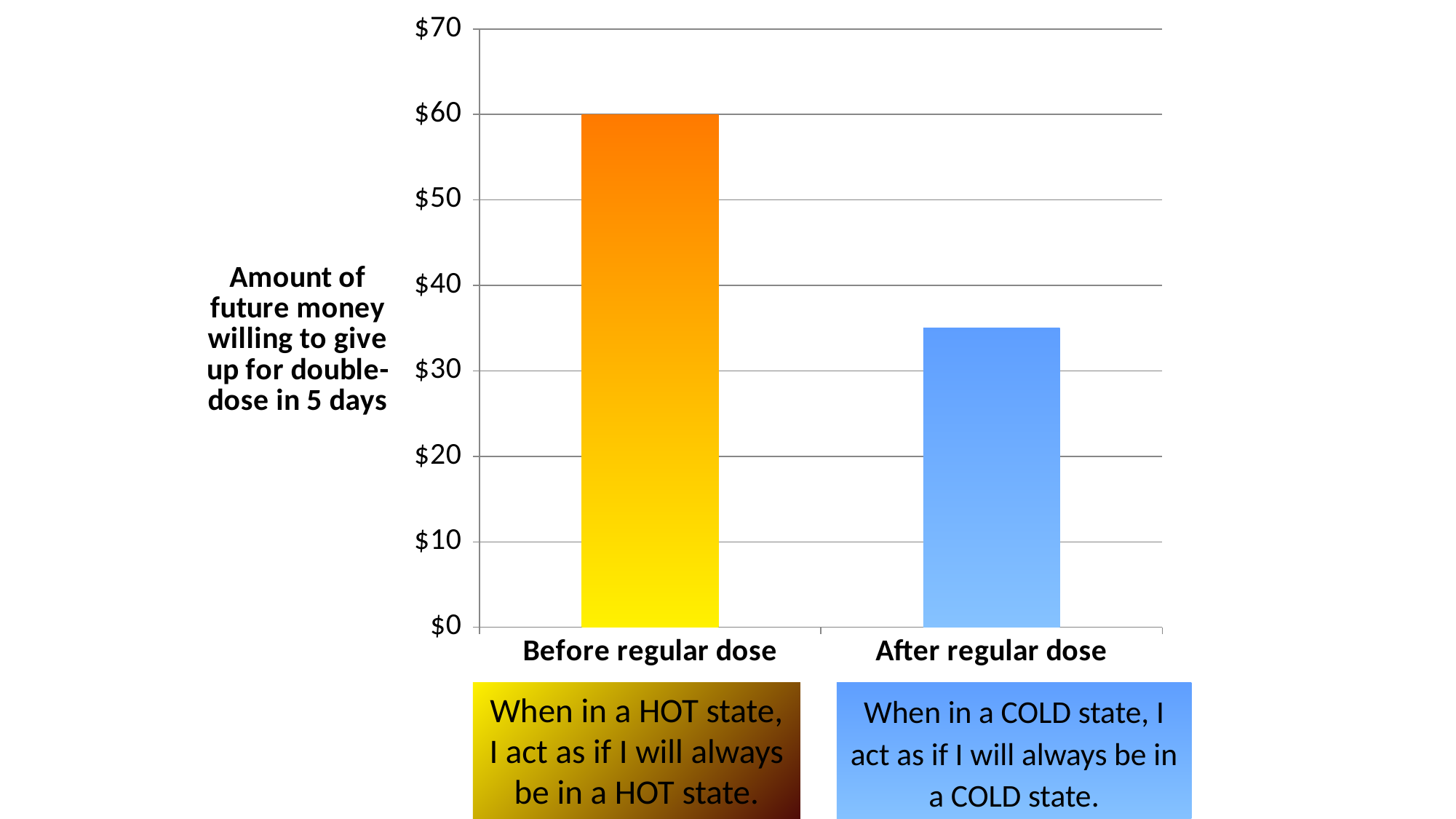
Which category has the highest value? Before regular dose What is the value for Before regular dose? $60 Which is larger, the value for Before regular dose or the value for After regular dose? Before regular dose Is the value for After regular dose greater or less than $40? less What is the label on the vertical axis of the chart? Amount of future money willing to give up for double-dose in 5 days What colour is the bar for After regular dose? blue How many categories are plotted in the chart? 2 Is the value for Before regular dose greater or less than $50? greater Is the value for After regular dose greater or less than $30? greater What kind of chart is shown on the slide? bar chart Do the values rise or fall from Before regular dose to After regular dose? fall Which category has the lowest value? After regular dose